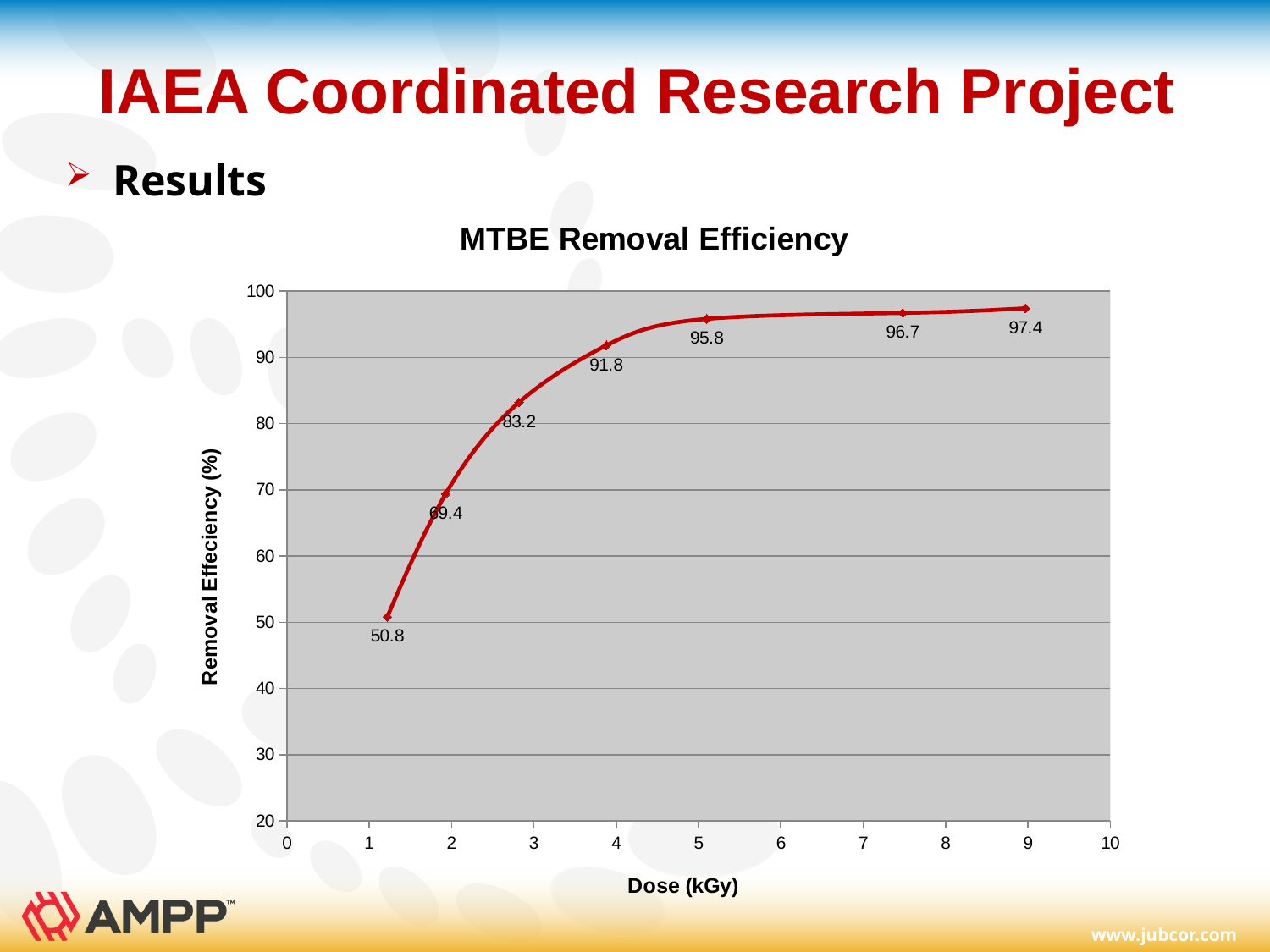
What is the title of the chart? MTBE Removal Efficiency What type of chart is shown on the slide? line chart What is the lowest removal efficiency value labelled on the chart? 50.8 What is the removal efficiency labelled at the fourth data point from the left? 91.8 Which is larger, the removal efficiency at the fifth data point (95.8) or at the sixth data point (96.7)? 96.7 How many data points are plotted on the chart? 7 What is the label of the x axis of the chart? Dose (kGy) What is the highest removal efficiency value labelled on the chart? 97.4 Does removal efficiency rise or fall as dose increases along the x axis? rises What is the difference between the highest and lowest labelled removal efficiency values? 46.6 Is the removal efficiency at the lowest-dose data point greater or less than 60? less What is the removal efficiency labelled at the third data point from the left? 83.2